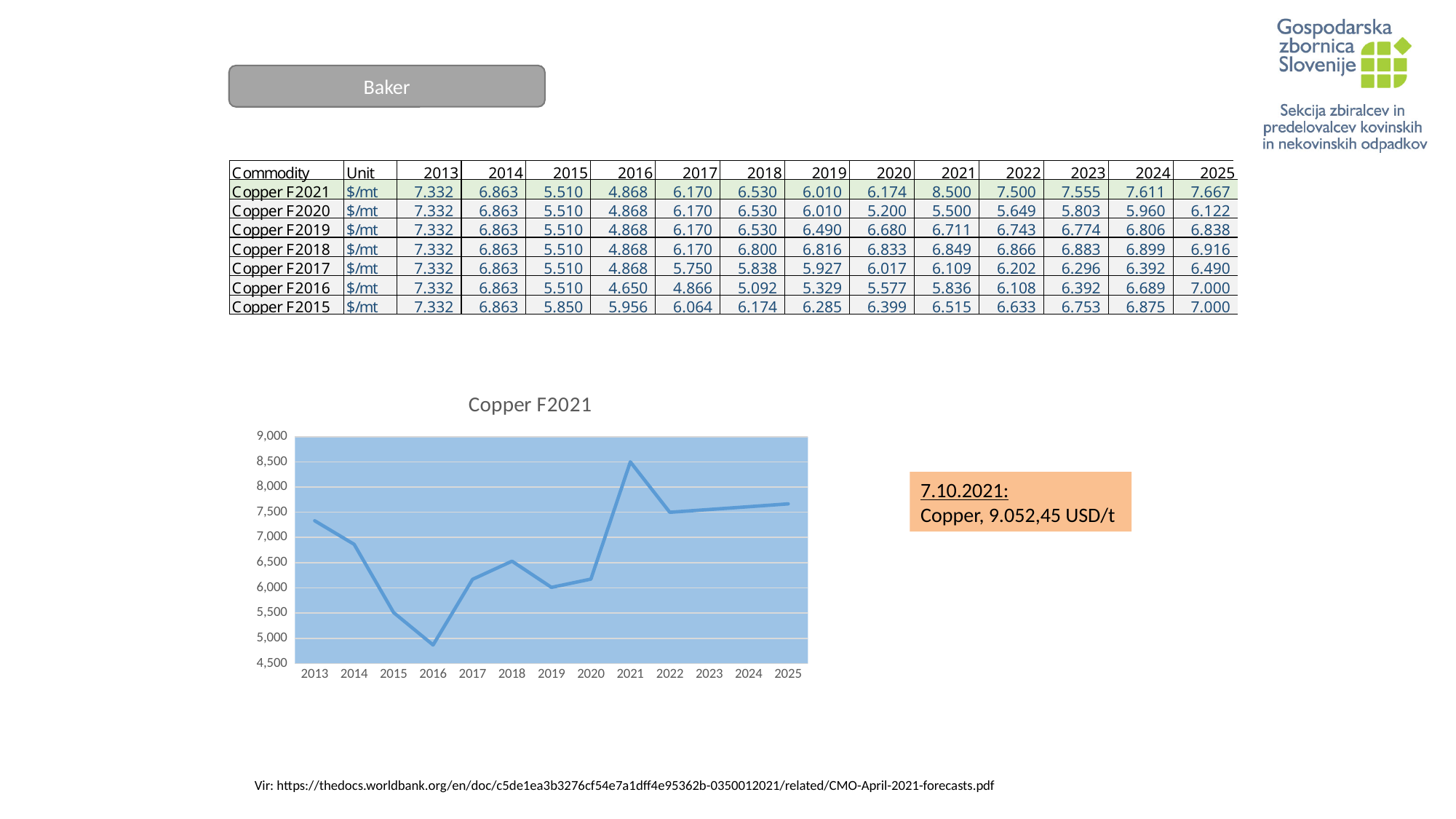
Using the table values, what is the difference between the Copper F2021 values for 2021 and 2022? 1.000 Is the value for 2016 on the chart greater or less than 5,000? less What kind of chart is shown on the slide? line chart How many years are plotted along the x axis of the chart? 13 According to the table, what is the Copper F2021 value for 2025? 7.667 Does the line rise or fall from 2013 to 2016? fall What is the title of the chart? Copper F2021 According to the table, what is the Copper F2021 value for 2021? 8.500 Is the value for 2021 on the chart greater or less than 8,000? greater In which year does the Copper F2021 line reach its highest value? 2021 Which year has the larger value on the chart, 2018 or 2019? 2018 In which year does the Copper F2021 line reach its lowest value? 2016